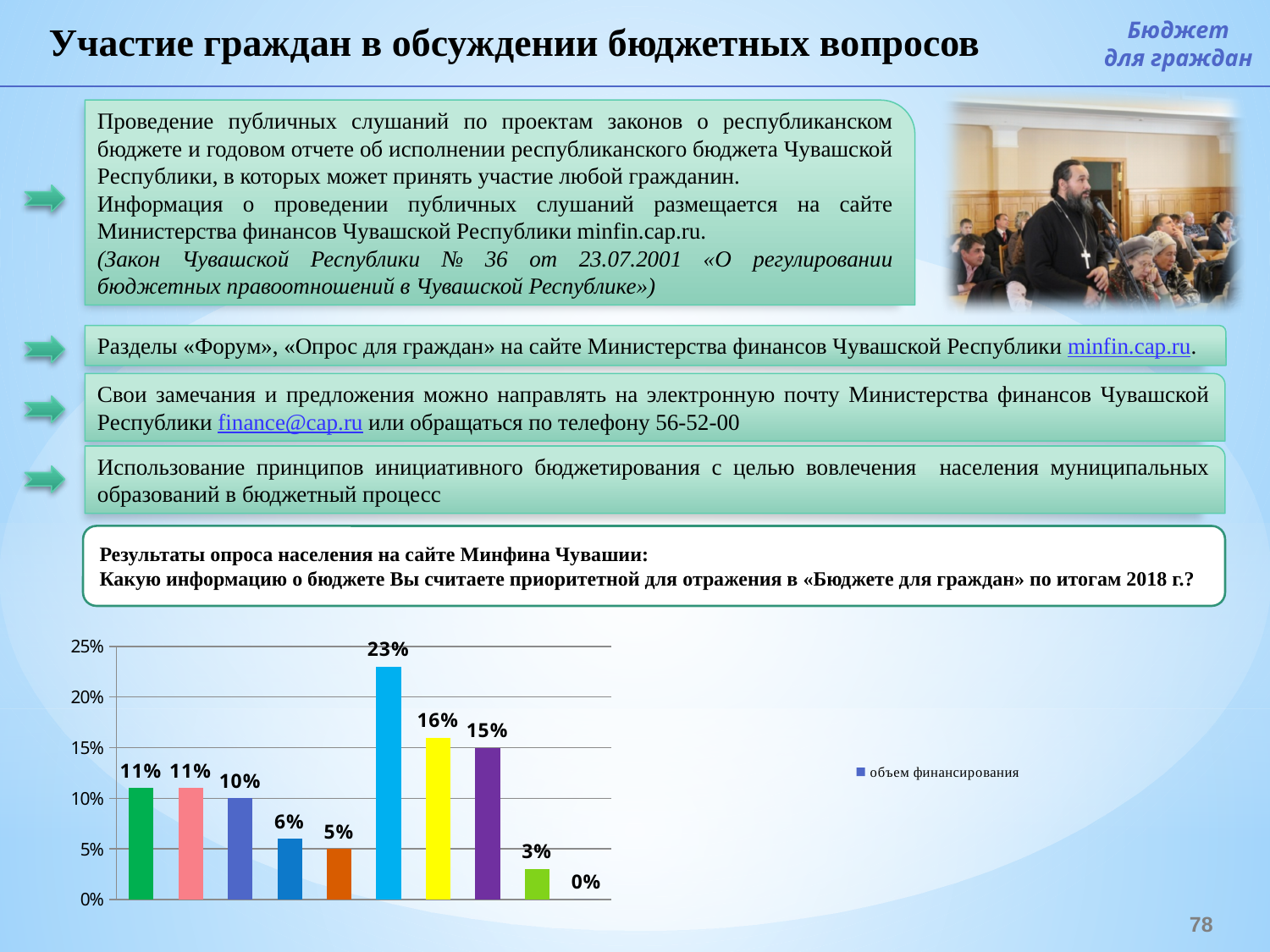
What value is shown for the yellow bar in the chart? 16% What is the difference between the tallest bar (23%) and the yellow bar (16%)? 7% What is the highest value shown in the bar chart? 23% How many series does the chart legend list? 1 Is the value of the light blue (cyan) bar greater or less than 20%? greater How many data labels (values) are shown in the bar chart? 10 What value is shown for the orange bar in the chart? 5% What is the lowest value shown in the bar chart? 0% What value is shown for the first (green) bar on the left of the chart? 11% What is the legend entry shown next to the chart? объем финансирования Which is larger: the value of the dark blue bar or the value of the orange bar? the dark blue bar (6%) What kind of chart is shown at the bottom of the slide? bar chart